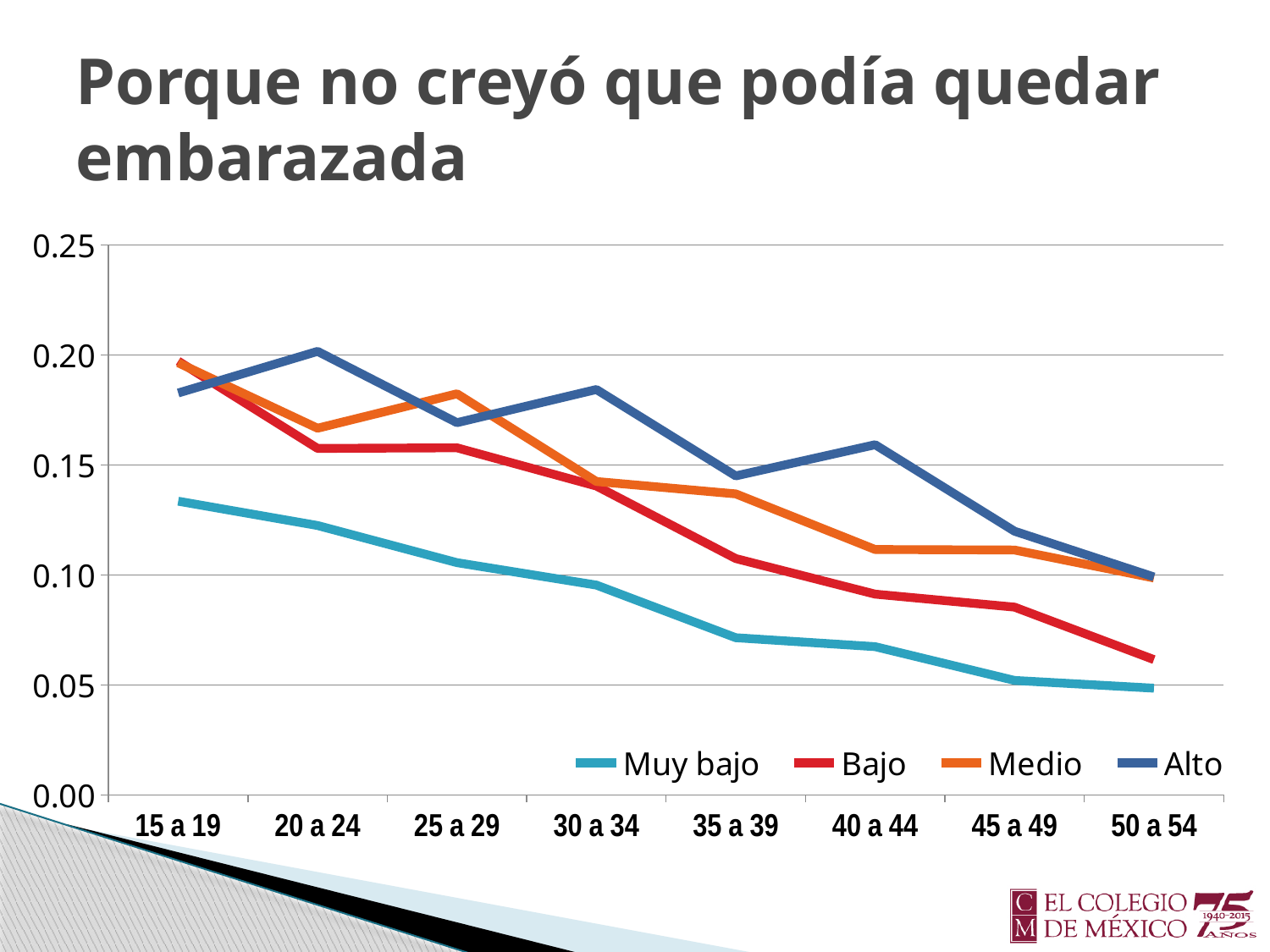
Which series has the lowest value at 15 a 19? Muy bajo How many series does the legend list? 4 Is the value for Medio at 25 a 29 greater or less than 0.15? greater Which series has the highest value at 40 a 44? Alto What kind of chart is shown on the slide? line chart What colour is the Bajo line in the legend? red How many age groups are shown on the x axis? 8 At 35 a 39, which series has the larger value, Alto or Muy bajo? Alto Is the value for Alto at 40 a 44 greater or less than 0.15? greater Is the value for Muy bajo at 15 a 19 greater or less than 0.15? less Does the Muy bajo series rise or fall across the age groups from 15 a 19 to 50 a 54? falls